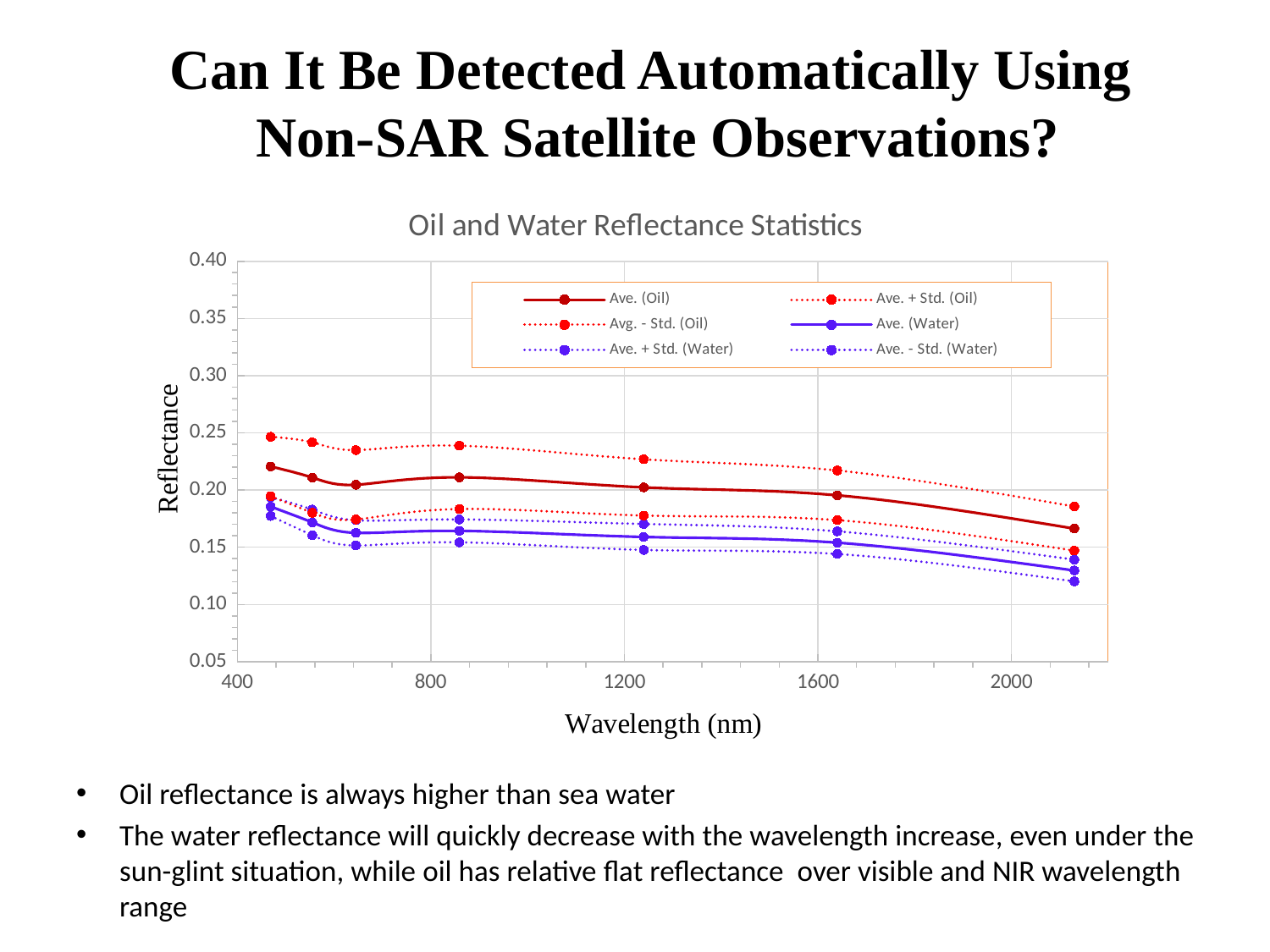
How many data points are plotted for the Ave. (Oil) series? 7 At the longest wavelength plotted, is the Ave. (Water) reflectance greater or less than 0.15? less What kind of chart is shown on the slide? line chart Which series has the highest reflectance values across the chart? Ave. + Std. (Oil) At the longest wavelength plotted, is the Ave. (Oil) reflectance greater or less than 0.15? greater Which series has the lowest reflectance values across the chart? Ave. - Std. (Water) At the shortest wavelength plotted, is the Ave. + Std. (Oil) reflectance greater or less than 0.20? greater What is the label of the x axis of the chart? Wavelength (nm) How many series does the legend of the chart list? 6 What is the title of the chart? Oil and Water Reflectance Statistics At a wavelength of about 1240 nm, which is larger: the Ave. (Oil) reflectance or the Ave. (Water) reflectance? Ave. (Oil) Does the Ave. (Water) reflectance rise or fall as wavelength increases along the x axis? fall